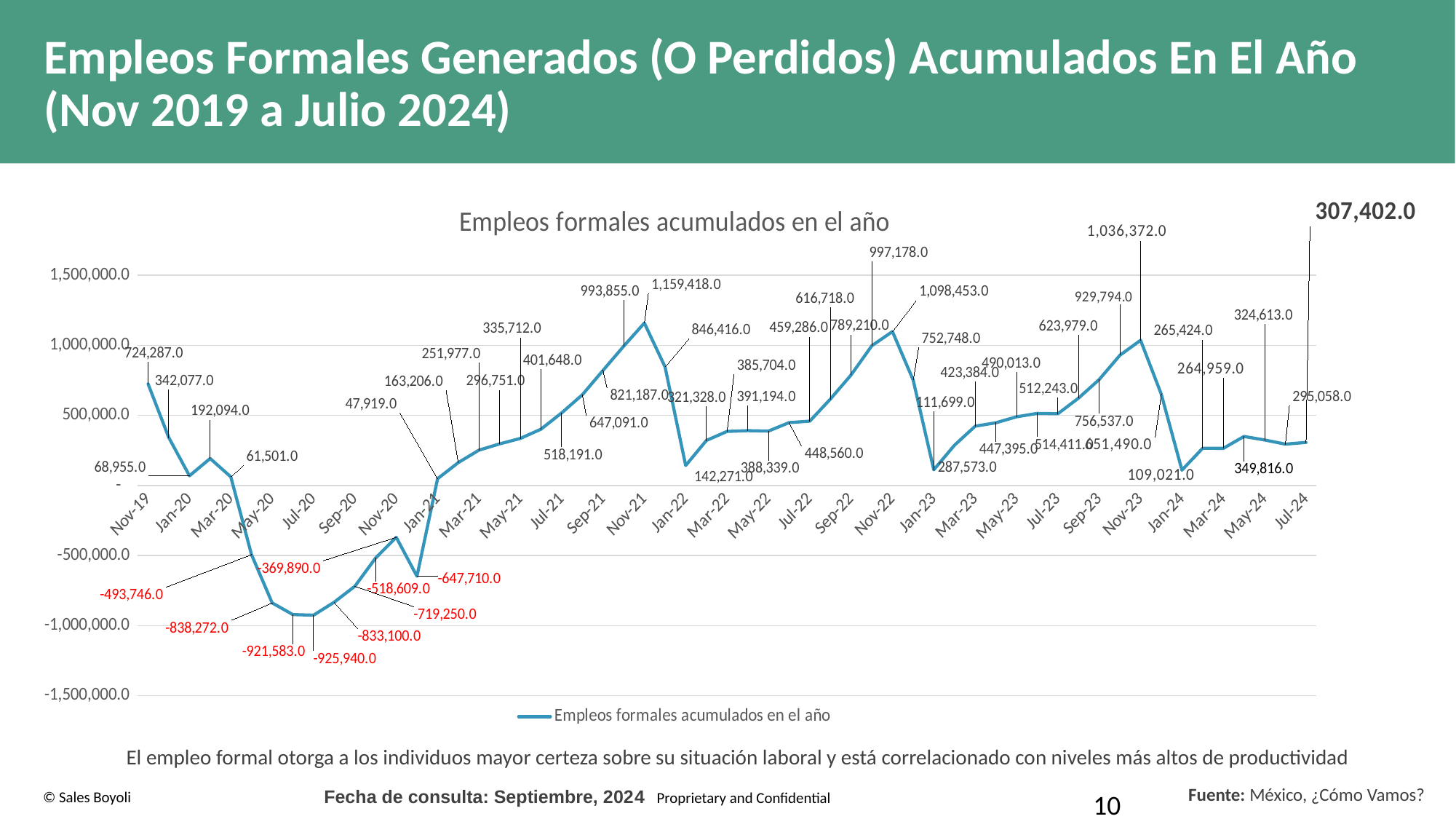
What is the title of the chart? Empleos formales acumulados en el año What is the value for Nov-19, the first point on the chart? 724,287.0 What is the value for Nov-21? 1,159,418.0 What is the difference between the value for Nov-21 (1,159,418.0) and the value for Nov-22 (1,098,453.0)? 60,965.0 What is the value for Jul-24, the last point on the chart? 307,402.0 What is the value for Nov-23? 1,036,372.0 Is the value for Jan-22 greater or less than 500,000? less Which month has the highest value on the chart? Nov-21 What kind of chart is shown on the slide? line chart Which is larger, the value for Nov-21 or the value for Nov-23? Nov-21 Do the values rise or fall between Mar-20 and Jul-20? fall How many series does the legend list? 1